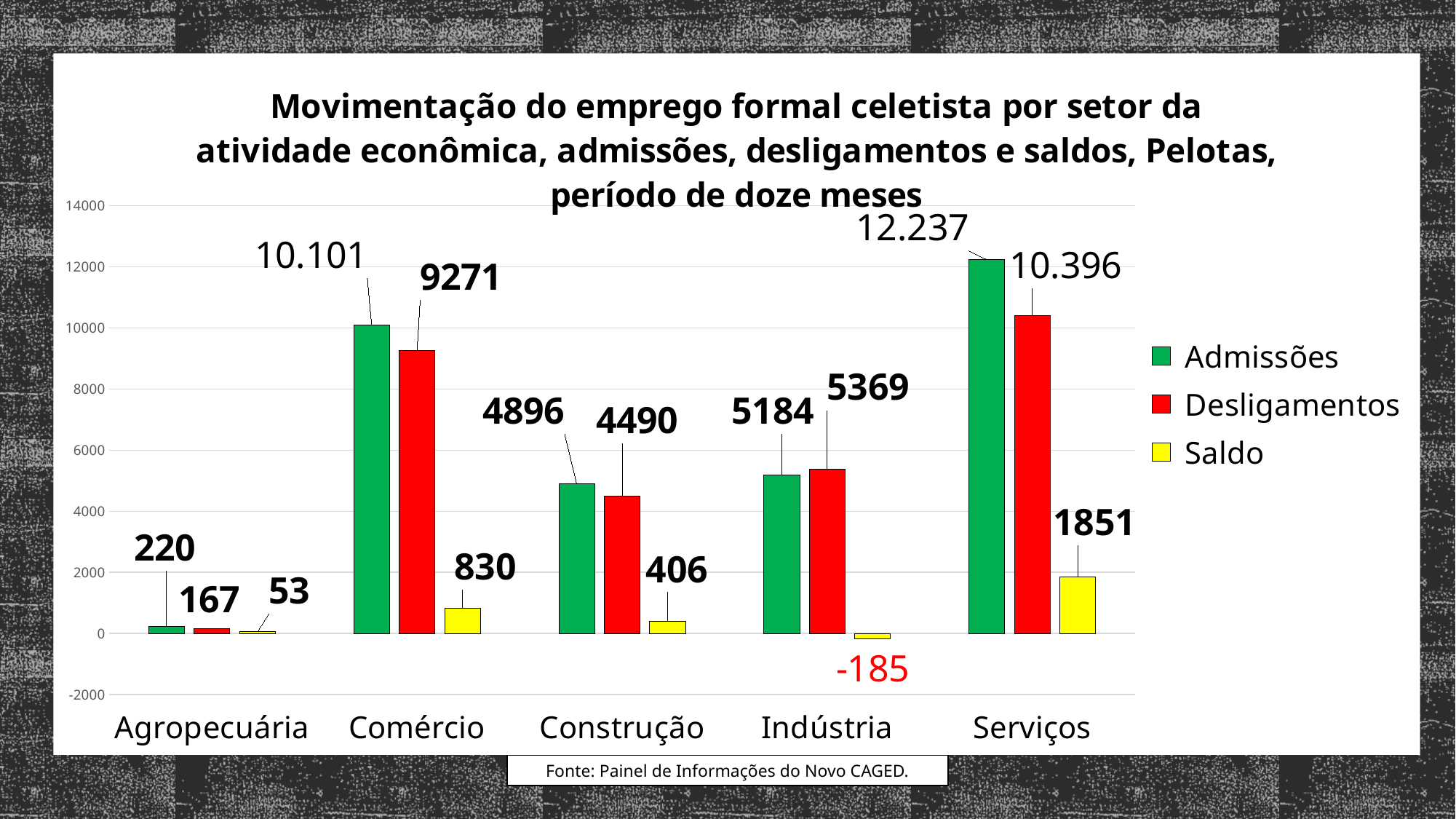
Which sector has the lowest value for Saldo? Indústria How many sectors are shown on the x axis? 5 Which sector has the highest value for Admissões? Serviços What is the value of Admissões for Comércio? 10.101 What colour represents the Saldo series in the legend? Yellow How many series does the legend list? 3 What is the difference between Admissões and Desligamentos for Construção? 406 What is the value of Saldo for Indústria? -185 What is the value of Desligamentos for Serviços? 10.396 For Indústria, which is larger: Admissões or Desligamentos? Desligamentos What is the value of Desligamentos for Agropecuária? 167 What kind of chart is shown on the slide? Bar chart